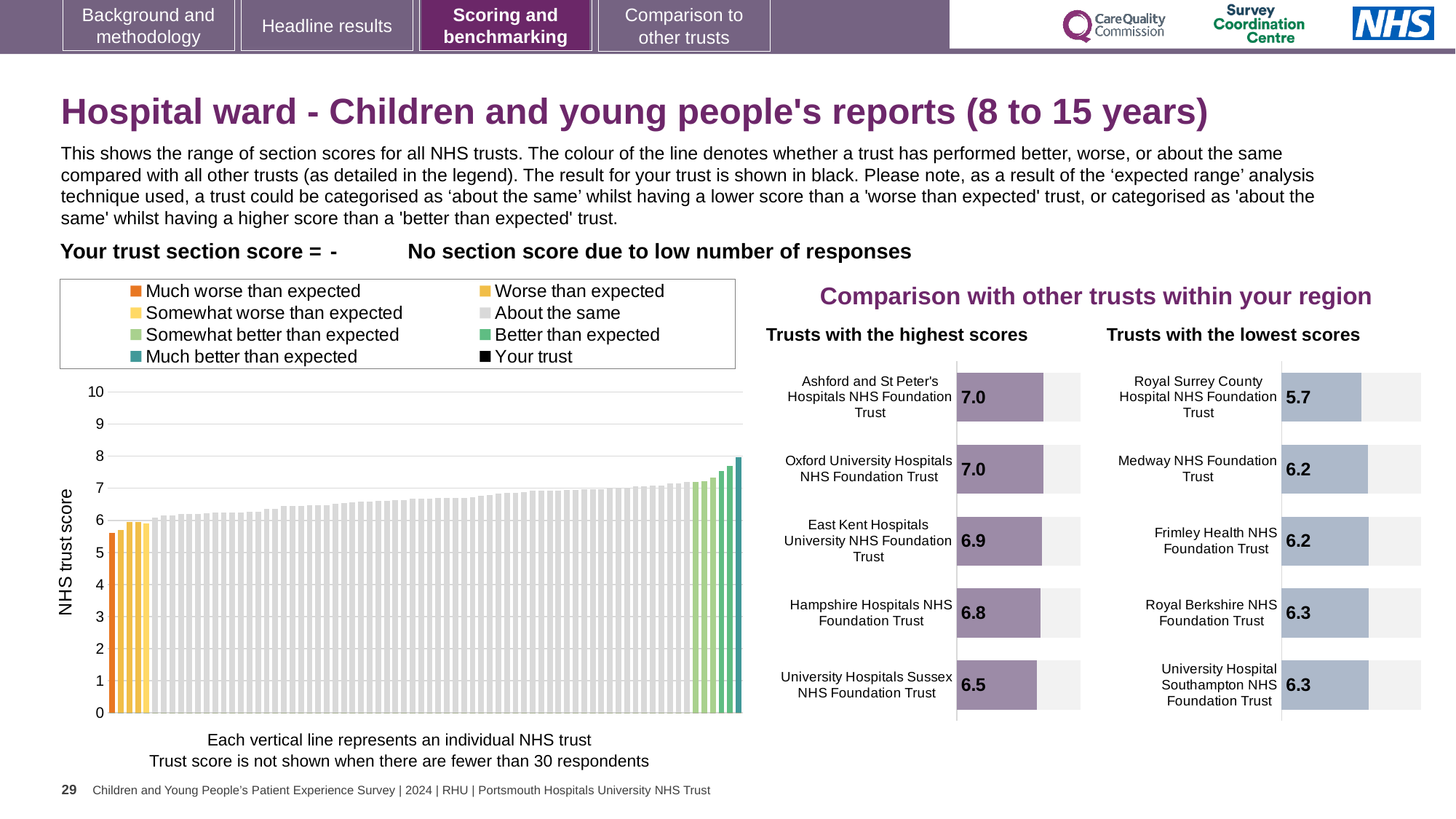
What is the y-axis label of the main chart on the left? NHS trust score How many trusts are listed in the 'Trusts with the highest scores' chart? 5 In the main 'NHS trust score' chart, is the value of the tallest bar greater or less than 7? greater In the 'Trusts with the highest scores' chart, which has the higher score: East Kent Hospitals University NHS Foundation Trust or Hampshire Hospitals NHS Foundation Trust? East Kent Hospitals University NHS Foundation Trust In the 'Trusts with the lowest scores' chart, what is the score for Royal Surrey County Hospital NHS Foundation Trust? 5.7 In the 'Trusts with the lowest scores' chart, what is the score for Medway NHS Foundation Trust? 6.2 What kind of chart is the main chart on the left showing NHS trust scores? Bar chart In the main 'NHS trust score' chart, do the bar values rise or fall from left to right? Rise In the 'Trusts with the highest scores' chart, what is the score for Hampshire Hospitals NHS Foundation Trust? 6.8 In the 'Trusts with the lowest scores' chart, which trust has the lowest score? Royal Surrey County Hospital NHS Foundation Trust How many entries does the legend of the main 'NHS trust score' chart list? 8 In the 'Trusts with the highest scores' chart, what is the difference between the scores of Ashford and St Peter's Hospitals NHS Foundation Trust and University Hospitals Sussex NHS Foundation Trust? 0.5